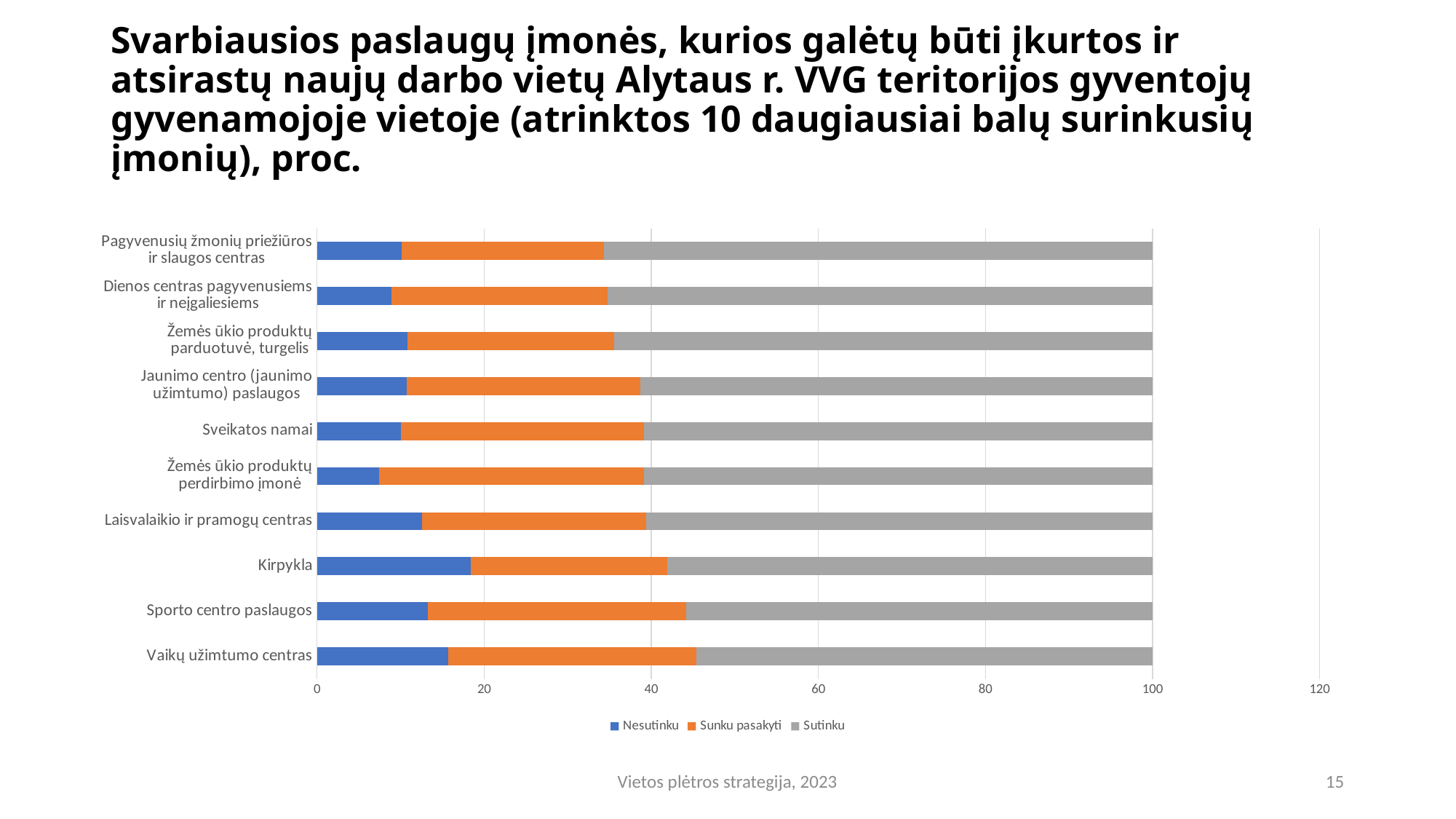
Which category has the largest Nesutinku value? Kirpykla How many series does the legend list? 3 Is the Nesutinku value for Kirpykla greater or less than 20? less What are the three series named in the legend? Nesutinku, Sunku pasakyti, Sutinku Which category has the smallest Nesutinku value? Žemės ūkio produktų perdirbimo įmonė Which has the larger Nesutinku value, Kirpykla or Sporto centro paslaugos? Kirpykla Is the Nesutinku value for Vaikų užimtumo centras greater or less than 20? less What is the total of the stacked bar for Vaikų užimtumo centras? 100 Which series is shown in grey on the chart? Sutinku Is the Sutinku value for Pagyvenusių žmonių priežiūros ir slaugos centras greater or less than 60? greater How many categories (service enterprises) are plotted on the chart? 10 What kind of chart is shown on the slide? stacked bar chart